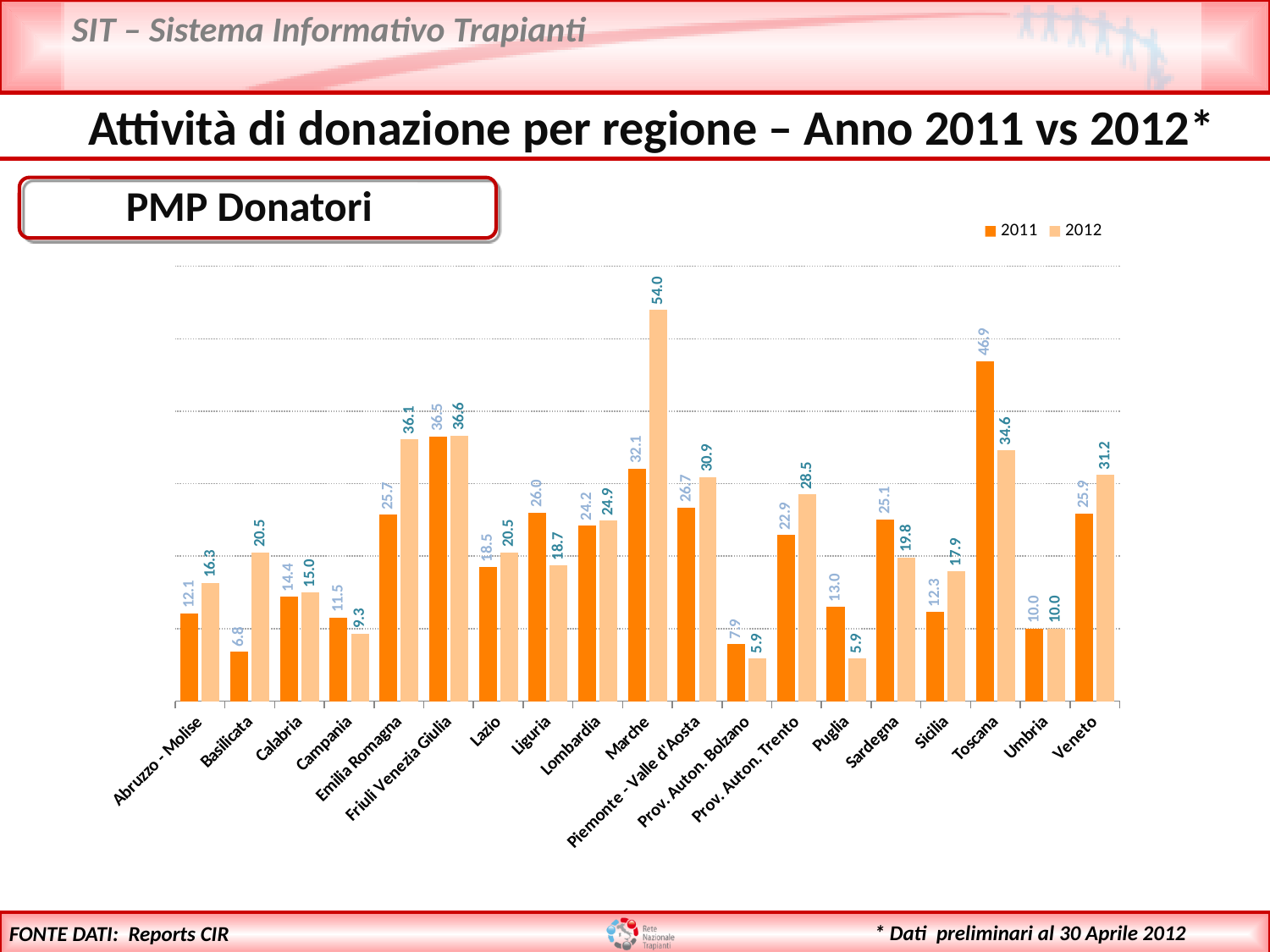
How many regions are shown on the x axis? 19 Which is larger for Toscana, the 2011 value or the 2012 value? 2011 What is the 2012 value for Marche? 54.0 What is the 2012 value for Prov. Auton. Trento? 28.5 Which region has the lowest 2011 value? Basilicata What is the 2011 value for Basilicata? 6.8 Which region has the highest 2011 value? Toscana Which region has the highest 2012 value? Marche What is the 2011 value for Toscana? 46.9 How many series does the legend list? 2 What kind of chart is shown? Bar chart What is the difference between the 2012 and 2011 values for Marche? 21.9